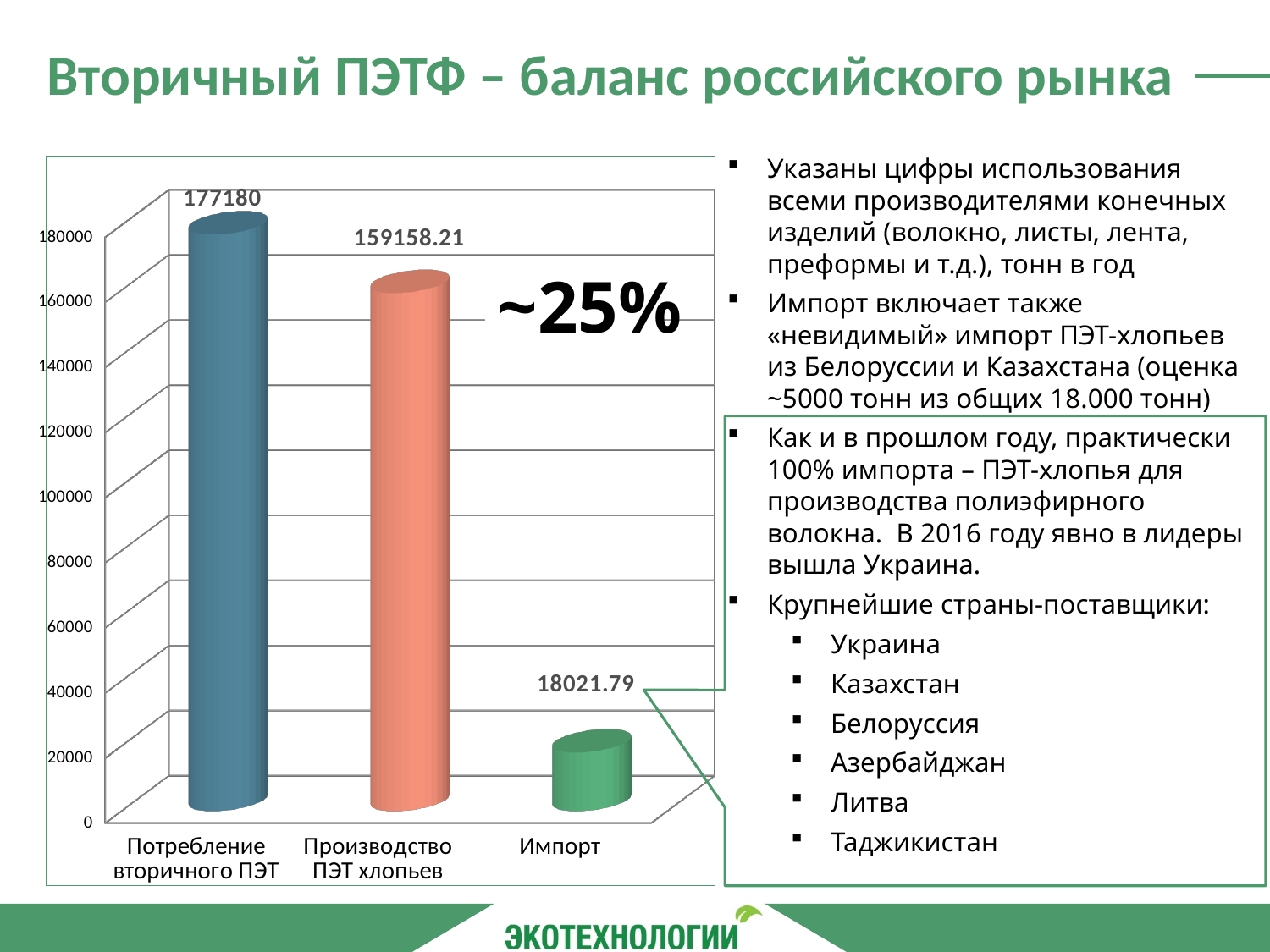
What kind of chart is shown on the slide? bar chart Is the value for Производство ПЭТ хлопьев greater or less than 140000? greater Which category has the lowest value? Импорт What percentage annotation is printed next to the bars on the chart? ~25% What is the value for Потребление вторичного ПЭТ? 177180 Which is larger, Производство ПЭТ хлопьев or Импорт? Производство ПЭТ хлопьев Which category has the highest value? Потребление вторичного ПЭТ What is the value for Импорт? 18021.79 What is the value for Производство ПЭТ хлопьев? 159158.21 How many categories are shown in the chart? 3 Is the value for Импорт greater or less than 20000? less What is the difference between Потребление вторичного ПЭТ and Производство ПЭТ хлопьев? 18021.79